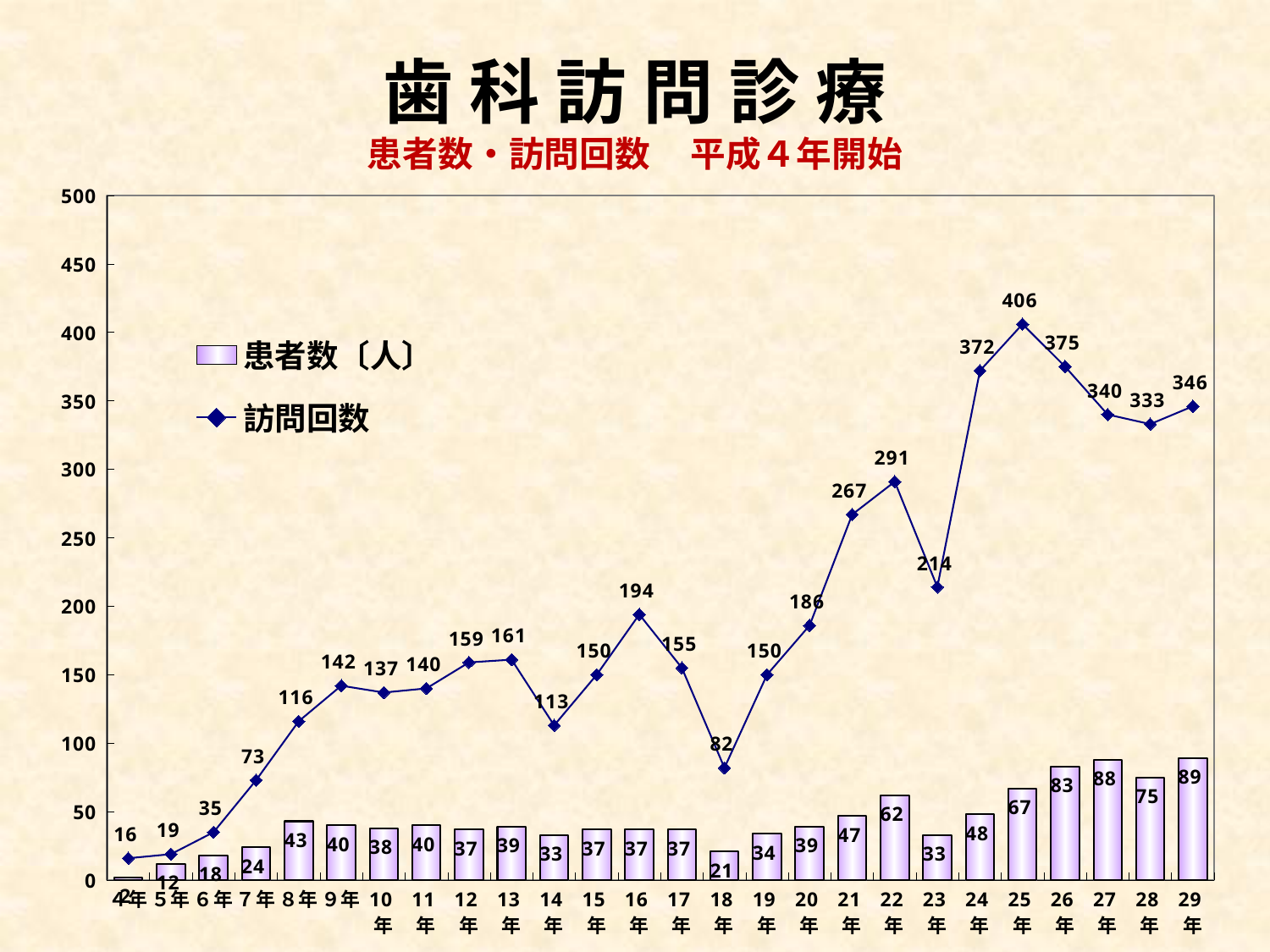
What kind of chart is this? Combined bar and line chart In which year was 患者数〔人〕 highest? 29年 What was the 患者数〔人〕 value in 22年? 62 In which year was 訪問回数 lowest? 4年 Does the 訪問回数 line generally rise or fall from 4年 to 29年? Rise What is the difference between the 訪問回数 values for 25年 and 26年? 31 How many series does the legend list? 2 What was the 訪問回数 value in 25年? 406 In which year was 訪問回数 highest? 25年 What was the 訪問回数 value in 18年? 82 Which year had a larger 患者数〔人〕 value, 26年 or 28年? 26年 How many years are shown on the x axis? 26